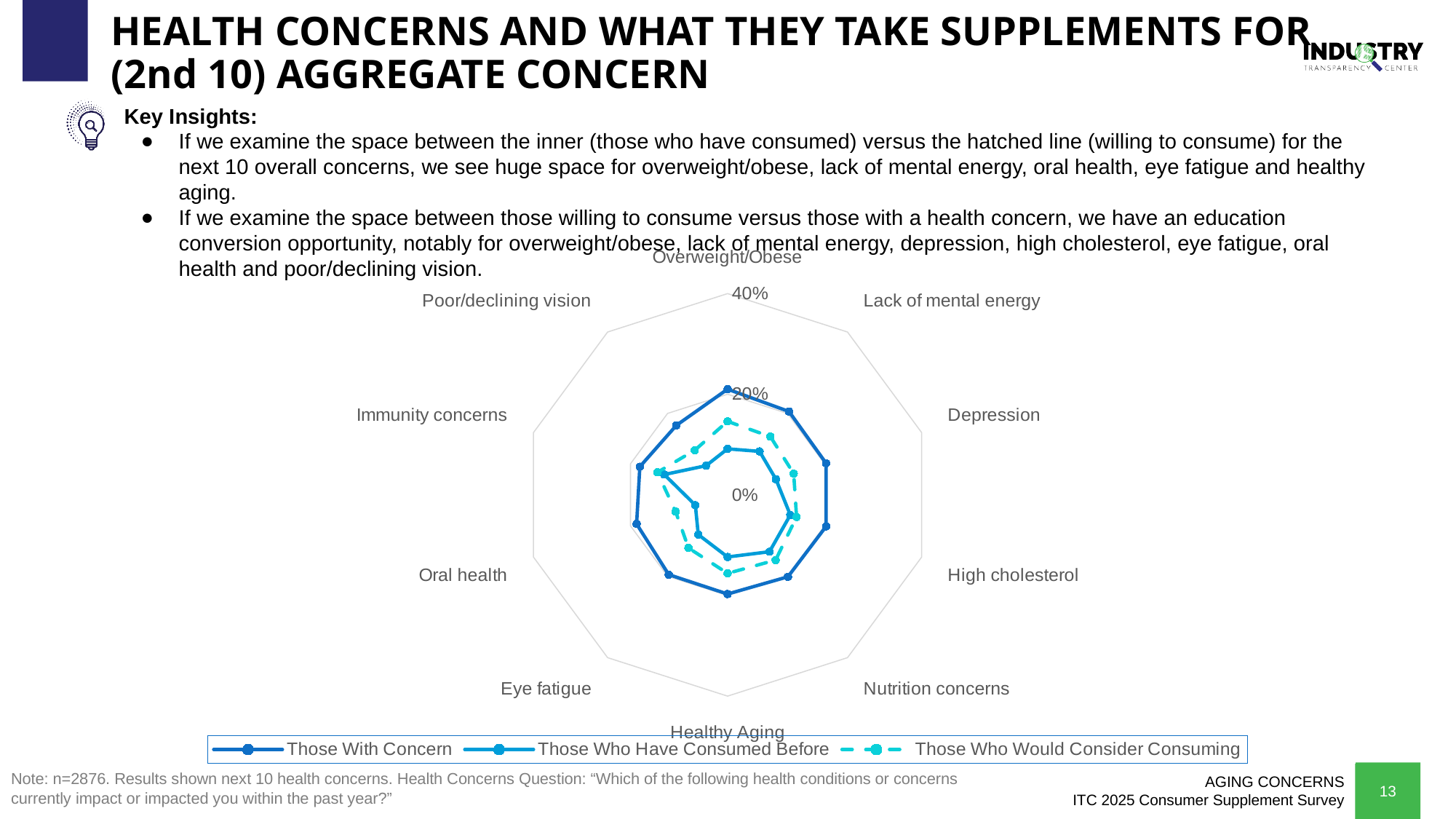
What is the highest percentage tick shown on the radar chart's axis? 40% Is the value for Those With Concern for Depression greater or less than 40%? less Is the value for Those Who Would Consider Consuming for Overweight/Obese greater or less than 20%? less For Immunity concerns, which is larger: Those With Concern or Those Who Have Consumed Before? Those With Concern For Overweight/Obese, which is larger: Those With Concern or Those Who Have Consumed Before? Those With Concern For Overweight/Obese, which is larger: Those Who Would Consider Consuming or Those Who Have Consumed Before? Those Who Would Consider Consuming Which series is shown with a dashed line on the radar chart? Those Who Would Consider Consuming How many series does the legend of the radar chart list? 3 What kind of chart is shown on the slide? Radar chart How many health concern categories are plotted on the radar chart? 10 Is the value for Those Who Have Consumed Before for Overweight/Obese greater or less than 20%? less